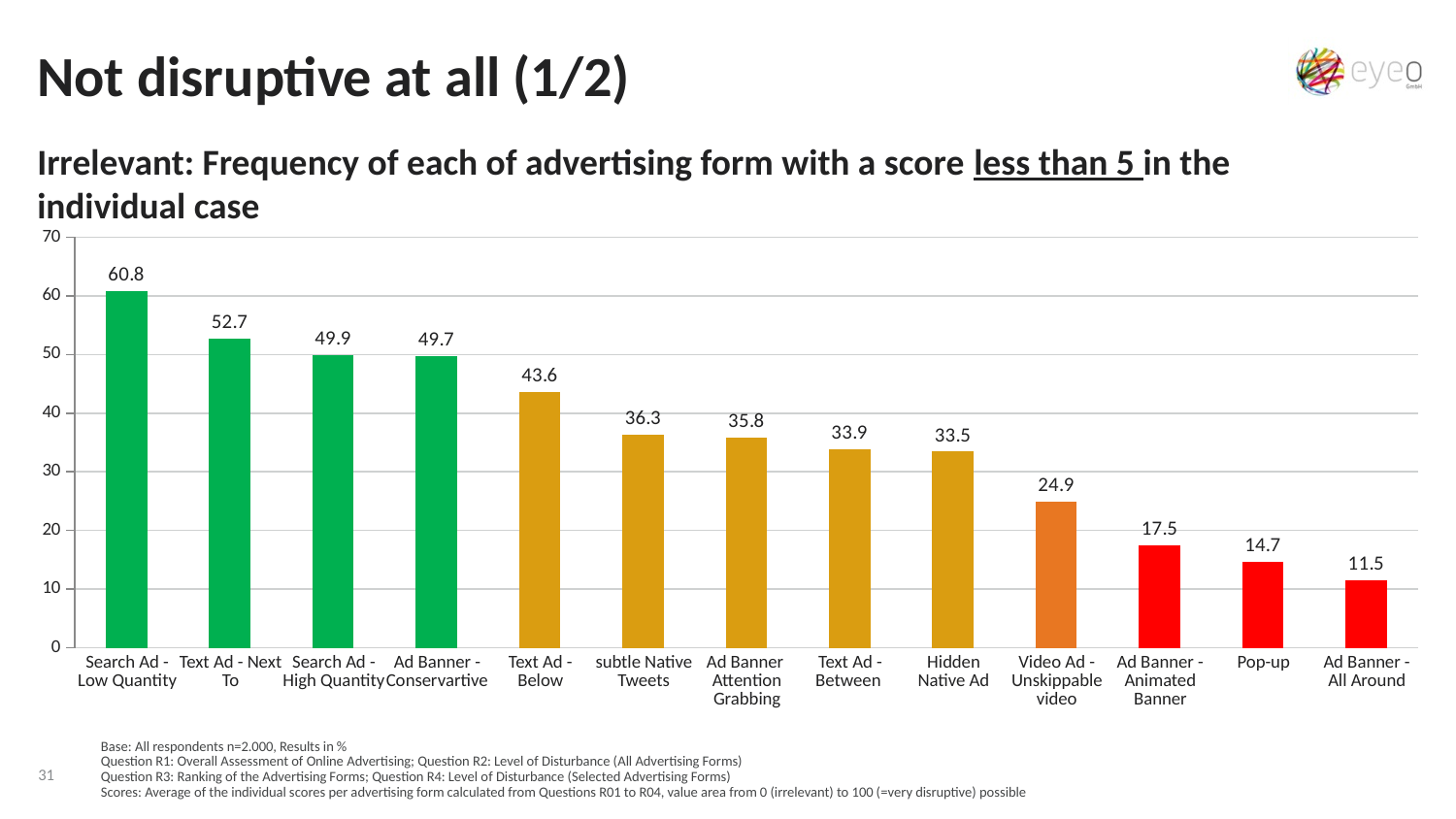
Which category has the lowest value? Ad Banner - All Around What is the value for Video Ad - Unskippable video? 24.9 How many categories are shown in the chart? 13 Which is larger, Text Ad - Below or subtle Native Tweets? Text Ad - Below What is the value for Search Ad - Low Quantity? 60.8 What kind of chart is shown on the slide? Bar chart Do the values rise or fall from left to right along the x axis? Fall What is the value for Pop-up? 14.7 What colour are the bars for Pop-up and Ad Banner - All Around? Red What is the difference between Search Ad - Low Quantity and Text Ad - Next To? 8.1 Which category has the highest value? Search Ad - Low Quantity Is the value for Hidden Native Ad greater or less than 30? greater